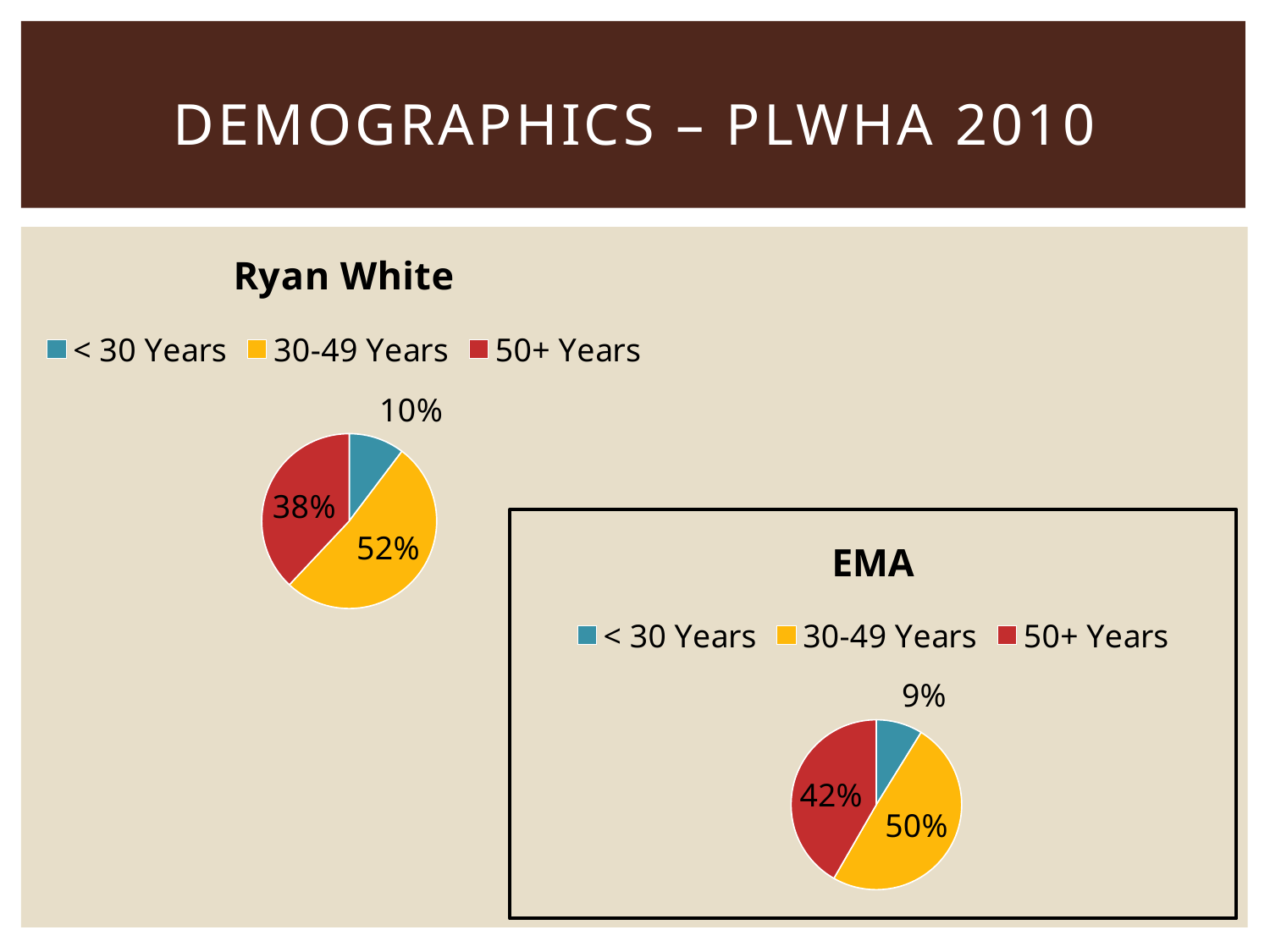
In the EMA chart, which age group has the smallest slice? < 30 Years In the Ryan White chart, what share of the pie is the 30-49 Years slice? 52% In the EMA chart, what share of the pie is the < 30 Years slice? 9% In the EMA chart, what is the value for 50+ Years? 42% Which is larger in the EMA chart: the 30-49 Years slice or the 50+ Years slice? 30-49 Years In the Ryan White chart, what is the difference between the 30-49 Years and 50+ Years slices? 14% In the Ryan White chart, what is the value for < 30 Years? 10% What kind of chart is the EMA chart? Pie chart How many slices does the Ryan White pie chart have? 3 How many entries does the legend of the Ryan White chart list? 3 In the EMA chart, what is the difference between the 50+ Years and < 30 Years slices? 33% In the Ryan White chart, which age group has the largest slice? 30-49 Years